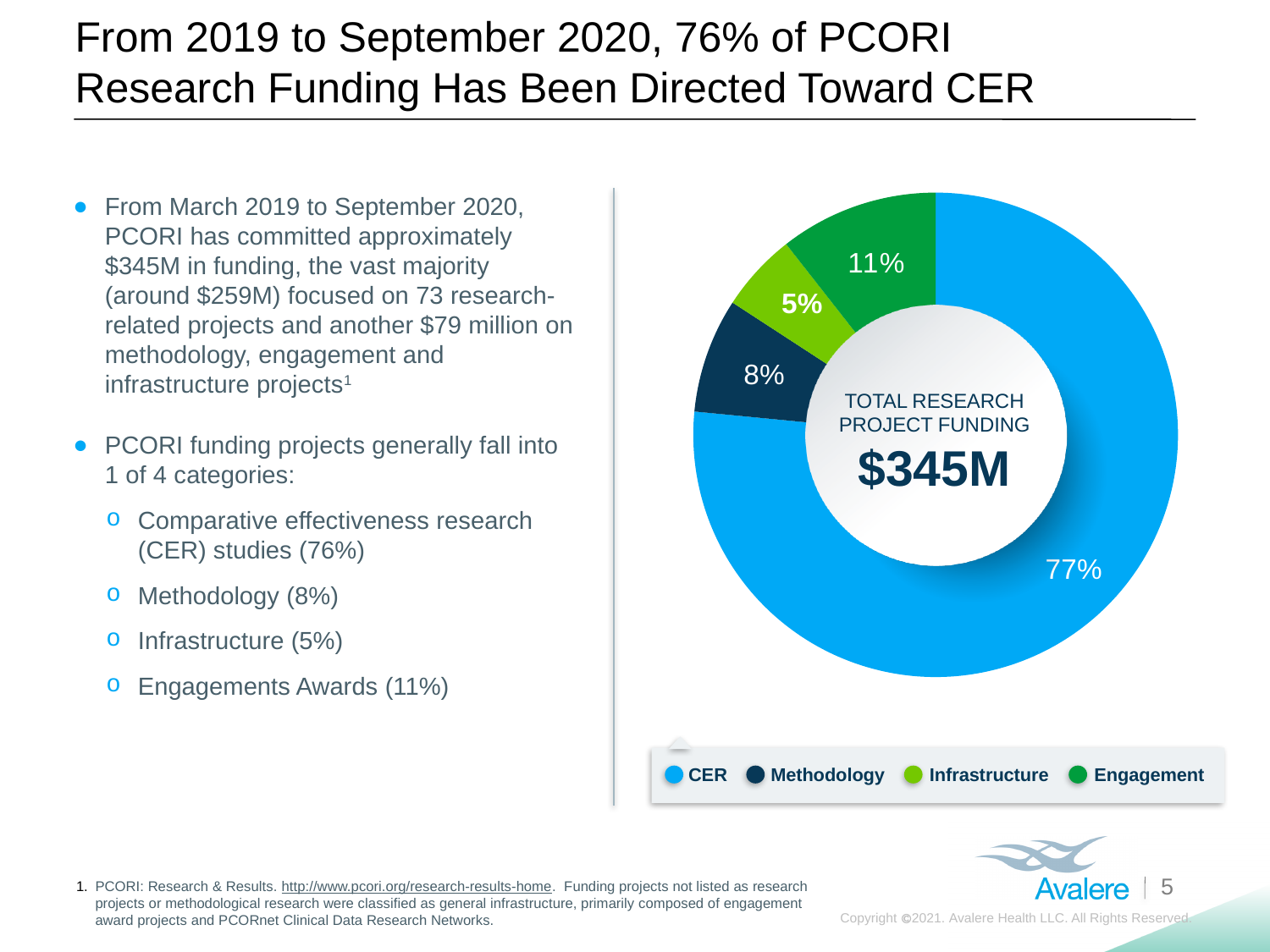
Which slice is larger in the donut chart, Engagement or Methodology? Engagement What kind of chart is shown on the slide? Pie (donut) chart What percentage is shown for Engagement in the donut chart? 11% What colour represents CER in the donut chart? Light blue Which category has the smallest slice in the donut chart? Infrastructure What percentage is shown for Methodology in the donut chart? 8% Which category has the largest slice in the donut chart? CER How many categories does the legend of the donut chart list? 4 What total funding amount is shown in the center of the donut chart? $345M What percentage is shown for Infrastructure in the donut chart? 5% What is the difference in percentage points between the CER slice and the Engagement slice? 66 What share of the donut chart does CER account for? 77%